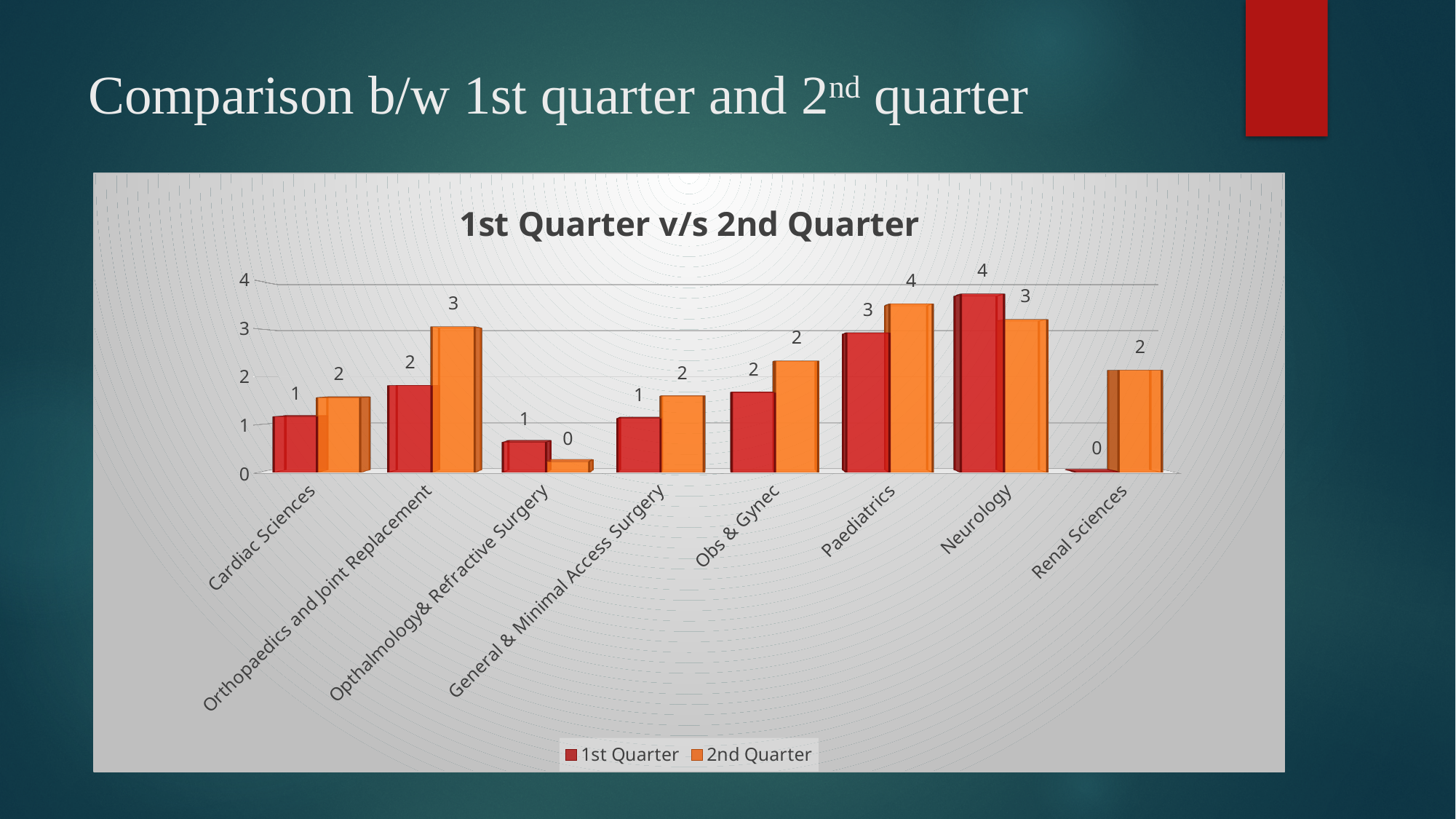
Which category has the highest 2nd Quarter value? Paediatrics What is the 1st Quarter value for Paediatrics? 3 For Neurology, which is larger: the 1st Quarter value or the 2nd Quarter value? 1st Quarter What is the 1st Quarter value for Neurology? 4 What type of chart is shown on the slide? Bar chart How many series does the legend list? 2 What is the 2nd Quarter value for Renal Sciences? 2 Which category has the lowest 1st Quarter value? Renal Sciences Which category has the lowest 2nd Quarter value? Opthalmology& Refractive Surgery What is the difference between the 2nd Quarter and 1st Quarter values for Cardiac Sciences? 1 How many categories are shown on the x axis? 8 What is the 2nd Quarter value for Orthopaedics and Joint Replacement? 3